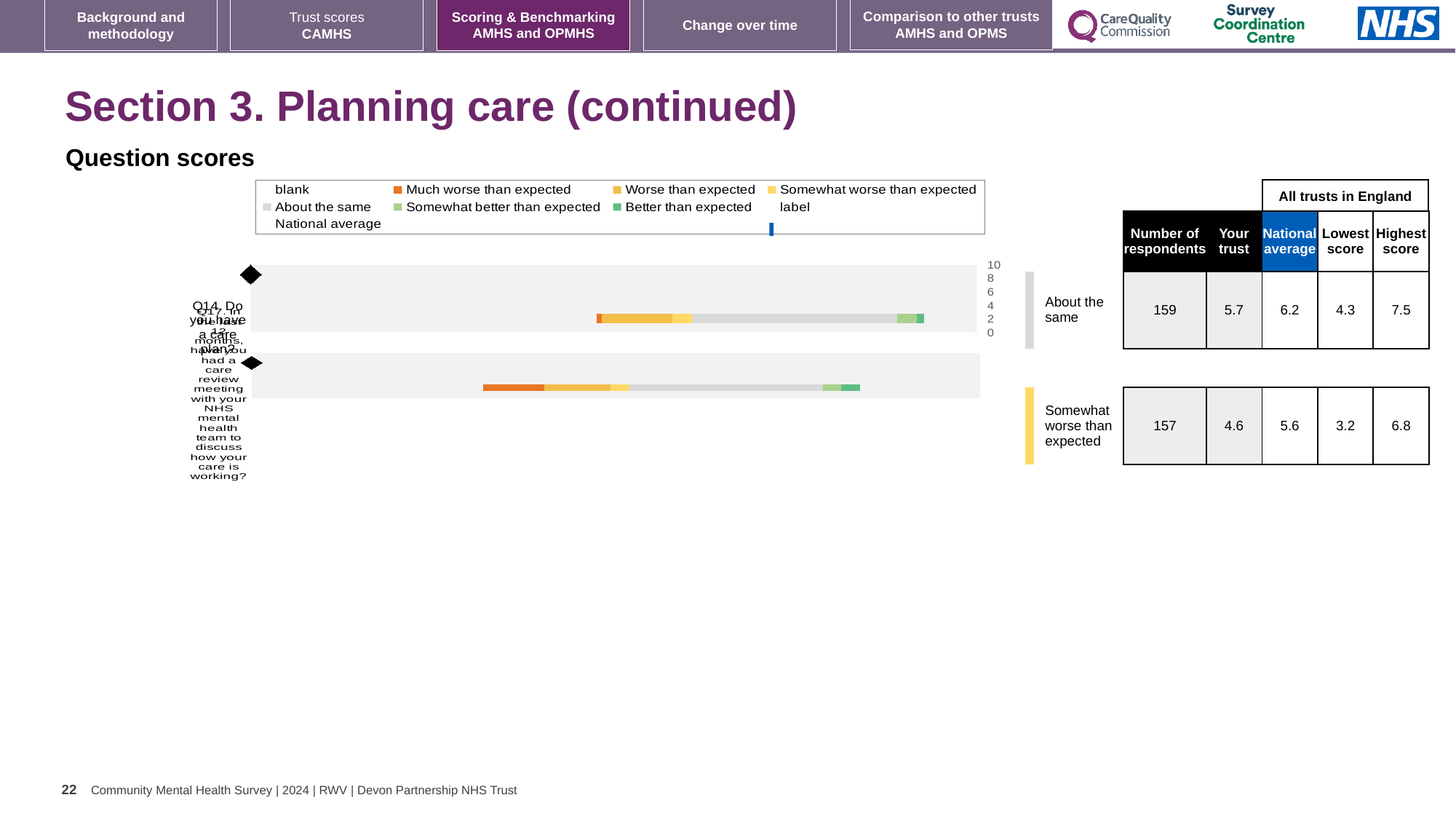
In the chart legend, what colour represents 'Much worse than expected'? orange In the table beside the chart, what is the number of respondents for the row rated 'About the same'? 159 For the row rated 'About the same', how much higher is the national average than the 'Your trust' score? 0.5 Which row has the larger 'Your trust' score, 'About the same' or 'Somewhat worse than expected'? About the same For the row rated 'Somewhat worse than expected', what is the difference between the highest score and the lowest score? 3.6 In the table beside the chart, what is the 'Your trust' score for the row rated 'Somewhat worse than expected'? 4.6 In the table beside the chart, what is the national average for the row rated 'About the same'? 6.2 How many question bars are plotted in the chart? 2 In the table beside the chart, what is the lowest score for the row rated 'About the same'? 4.3 What kind of chart is shown under 'Question scores'? bar chart In the chart legend, what colour represents 'Better than expected'? green In the table beside the chart, what is the highest score for the row rated 'Somewhat worse than expected'? 6.8